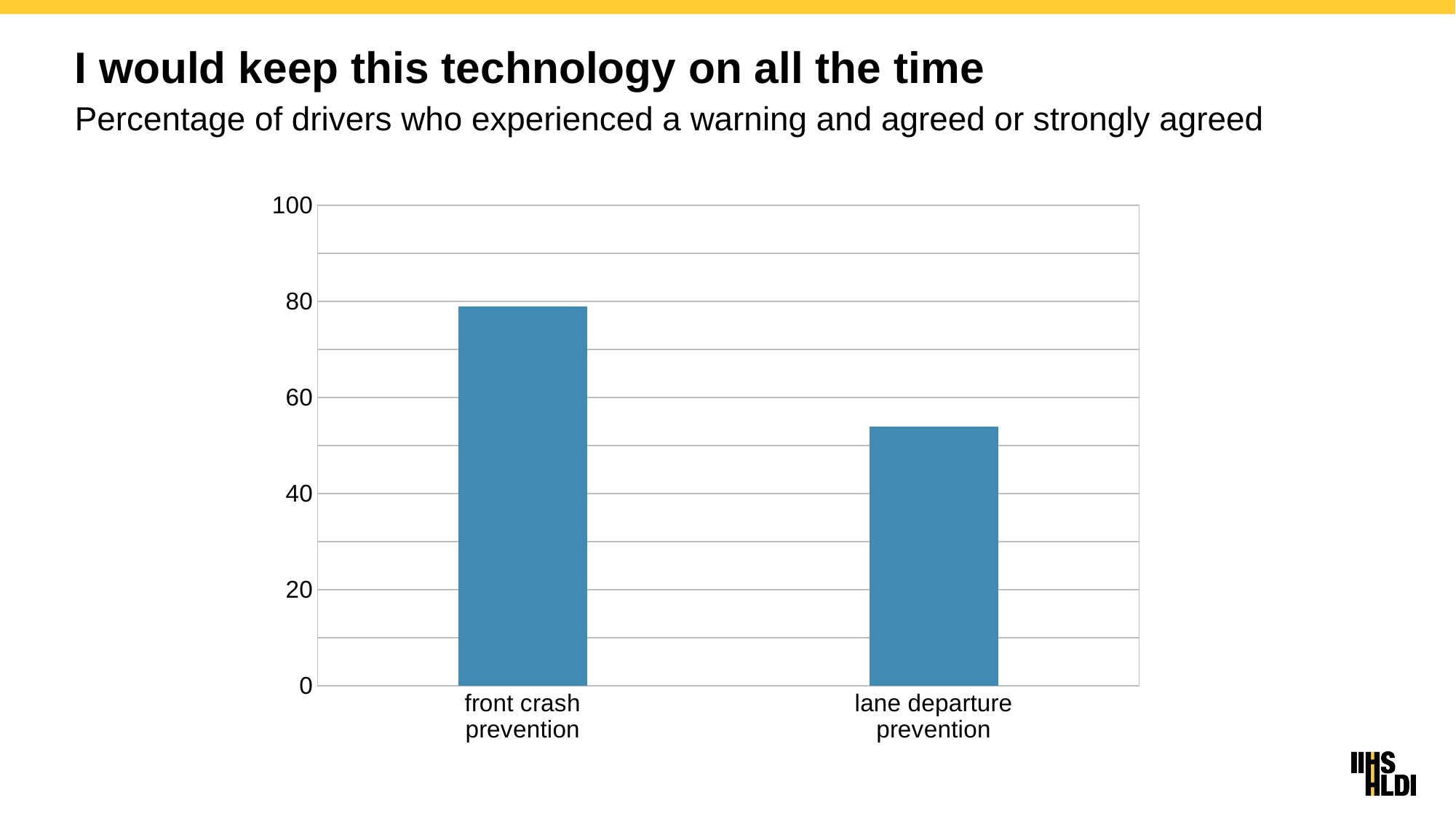
What is the maximum value shown on the vertical axis? 100 Is the value for lane departure prevention greater or less than 40? greater Is the value for lane departure prevention greater or less than 60? less Which is larger, the value for front crash prevention or the value for lane departure prevention? front crash prevention What is the title of the chart on the slide? I would keep this technology on all the time What kind of chart is shown on the slide? bar chart Which category has the highest value? front crash prevention Which category has the lowest value? lane departure prevention Is the value for front crash prevention greater or less than 60? greater How many categories are plotted on the chart? 2